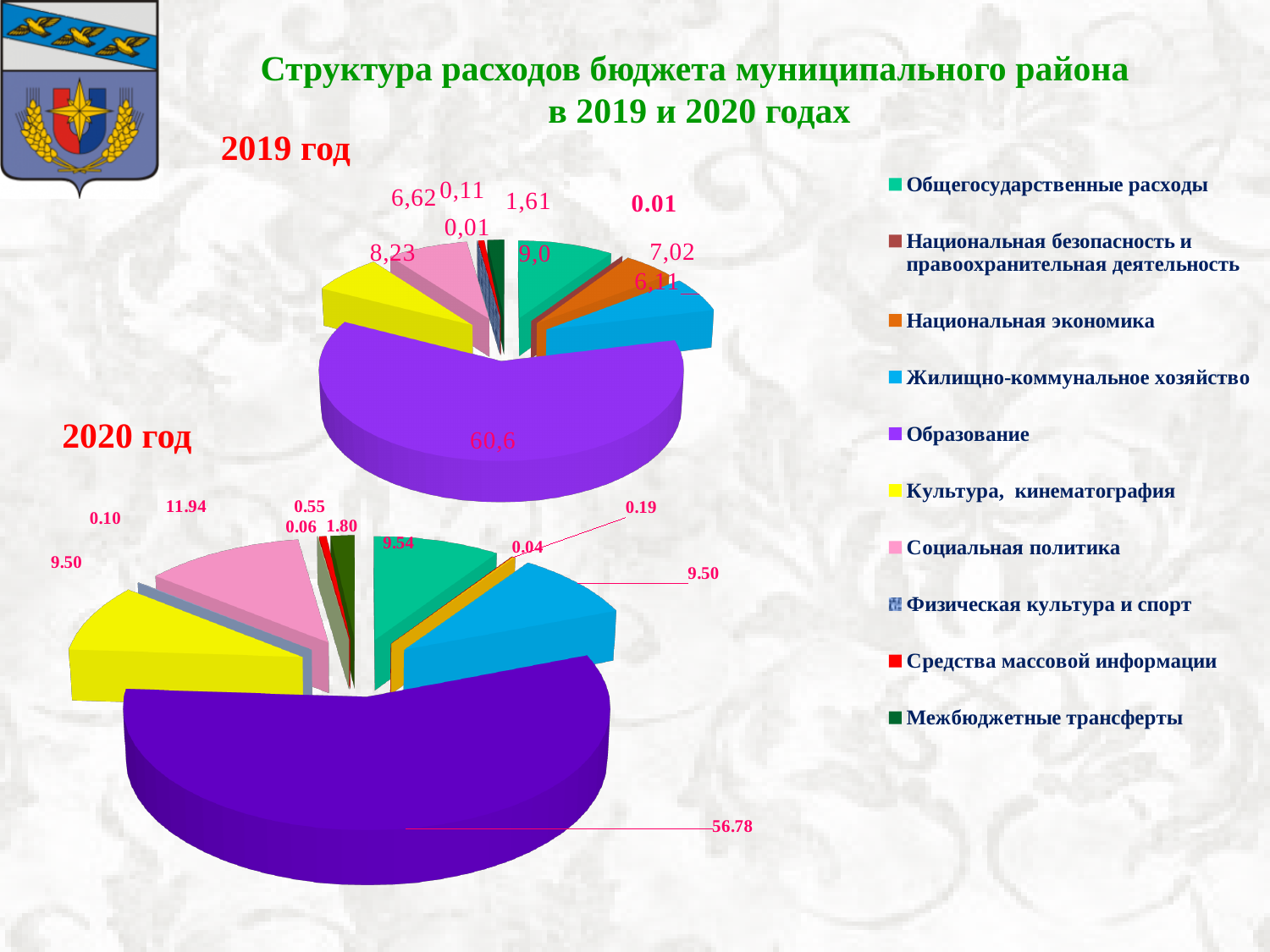
In the 2020 год chart, which category has the largest share? Образование In the 2019 год chart, which is larger: Культура, кинематография or Социальная политика? Культура, кинематография In the 2019 год chart, what is the value for Общегосударственные расходы? 9,0 In the 2019 год chart, what is the value for Культура, кинематография? 8,23 In the 2020 год chart, what is the value for Социальная политика? 11.94 What kind of charts are shown on the slide? Pie charts Is the share of Образование larger in the 2019 год chart or the 2020 год chart? 2019 год In the 2020 год chart, what is the value for Образование? 56.78 How many categories does the legend list? 10 In the 2019 год chart, what is the value for Образование? 60,6 In the 2019 год chart, which category has the largest share? Образование In the 2020 год chart, what is the value for Общегосударственные расходы? 9.54